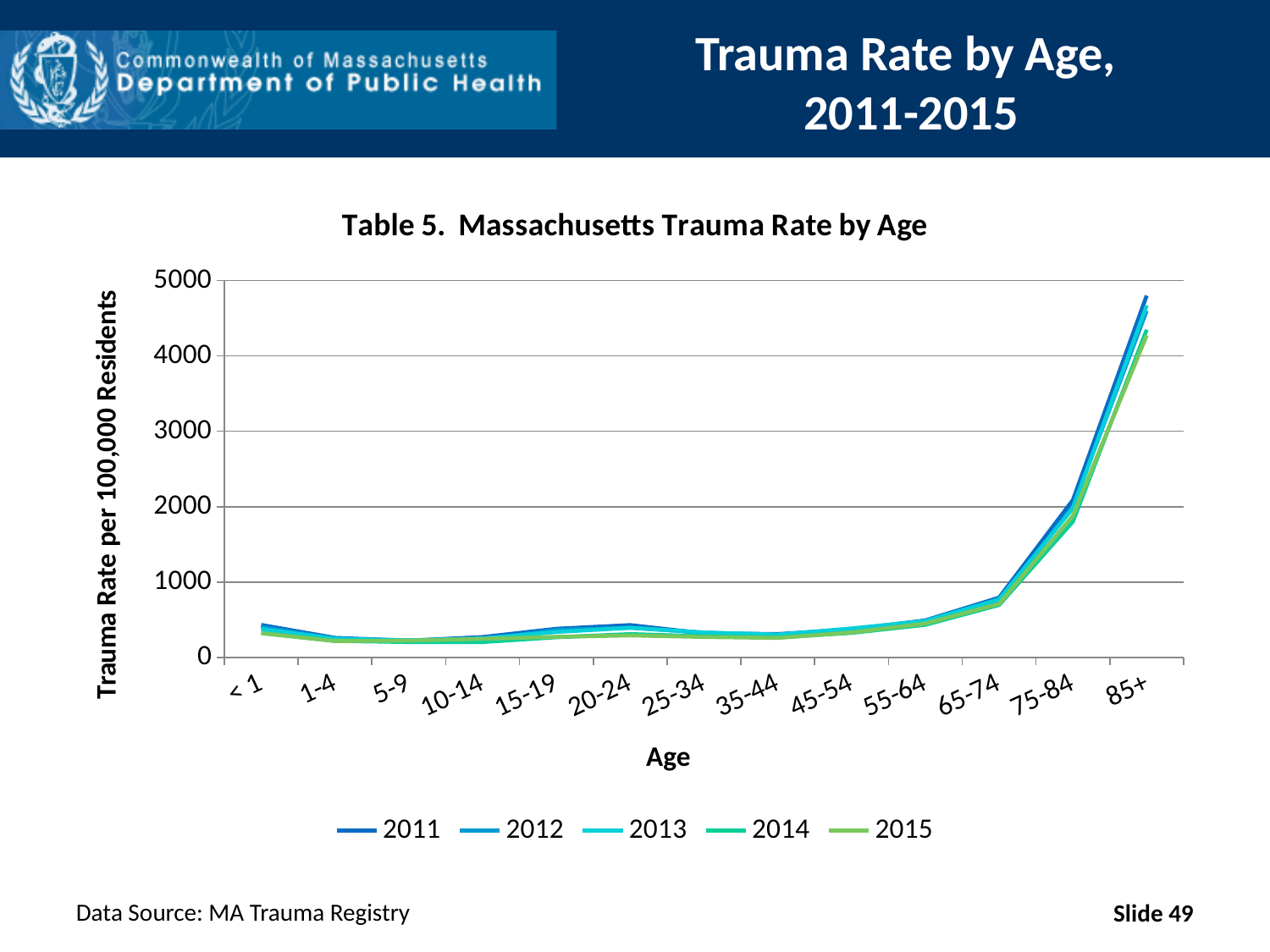
Which age group has a higher trauma rate, 65-74 or 85+? 85+ What kind of chart is shown on the slide? Line chart Is the 2011 trauma rate for the 85+ age group greater or less than 4000? greater How many series does the legend list? 5 What is the label of the y axis? Trauma Rate per 100,000 Residents Is the trauma rate for the 65-74 age group greater or less than 1000? less How many age categories are shown on the x axis? 13 Which age category has the highest trauma rate? 85+ What is the title of the chart? Table 5. Massachusetts Trauma Rate by Age Do the trauma rates rise or fall from the 45-54 age group to the 85+ age group? rise Is the trauma rate for the 20-24 age group greater or less than 1000? less